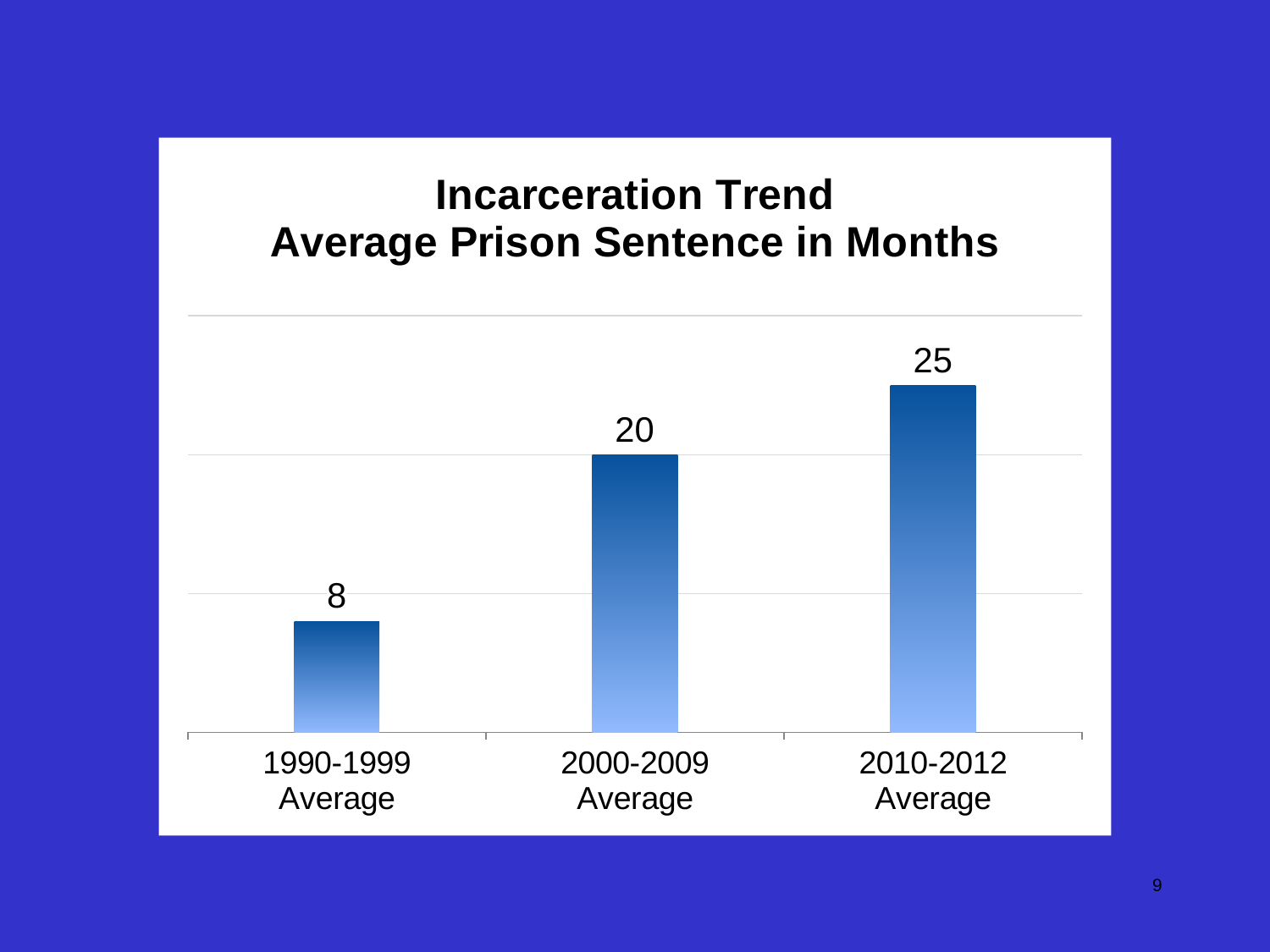
What is the average prison sentence in months for the 1990-1999 Average? 8 What kind of chart is shown on the slide? Bar chart What is the difference in months between the 2000-2009 Average and the 1990-1999 Average? 12 Which is larger, the 2000-2009 Average or the 2010-2012 Average? 2010-2012 Average Which period has the lowest average prison sentence? 1990-1999 Average What is the average prison sentence in months for the 2010-2012 Average? 25 How many periods are shown in the chart? 3 What is the title of the chart? Incarceration Trend Average Prison Sentence in Months What is the average prison sentence in months for the 2000-2009 Average? 20 Which period has the highest average prison sentence? 2010-2012 Average What is the difference in months between the 2010-2012 Average and the 1990-1999 Average? 17 Do the average prison sentence values rise or fall from the 1990-1999 Average to the 2010-2012 Average? Rise